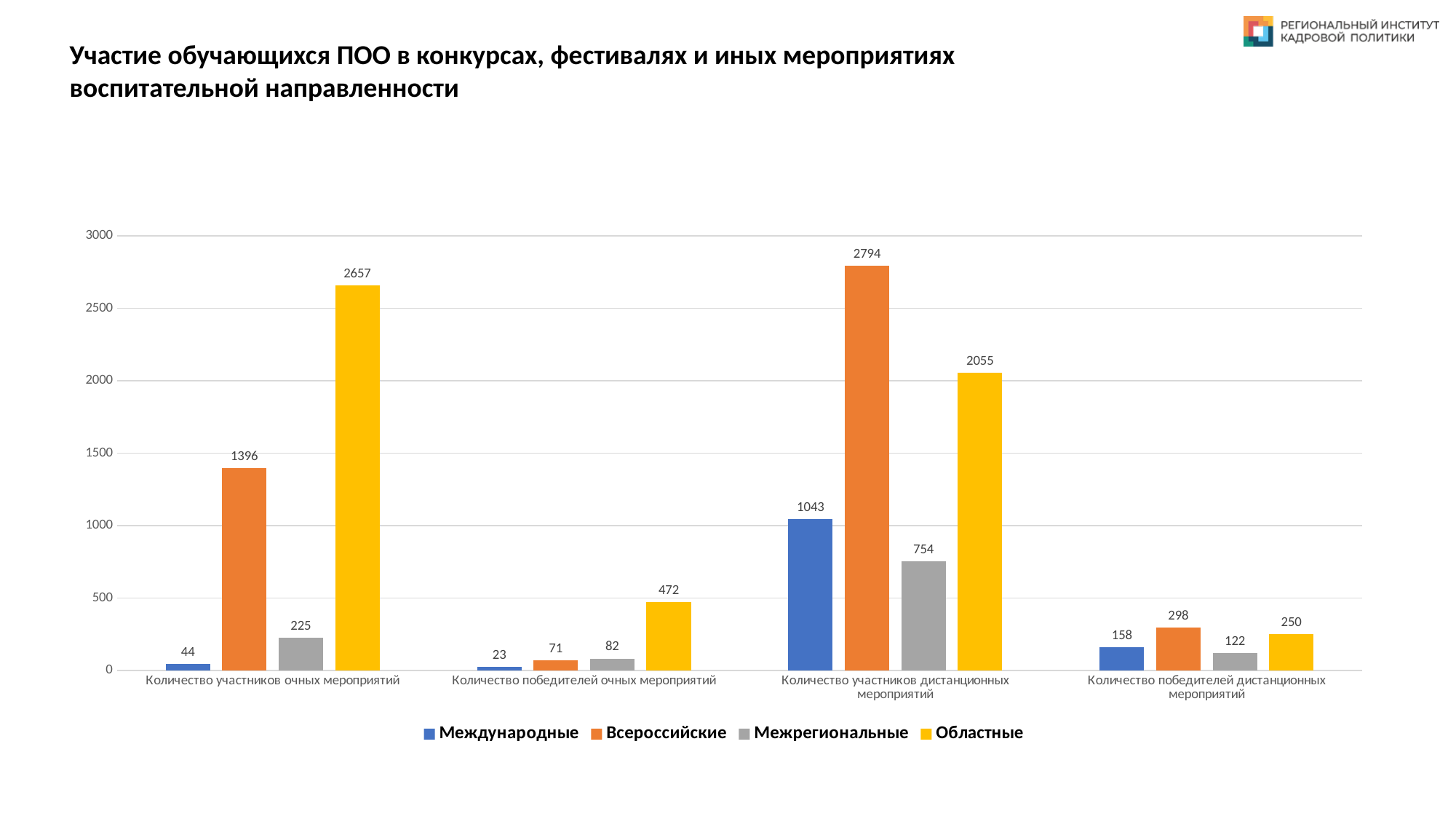
Which series has the lowest value in the category Количество победителей очных мероприятий? Международные What is the total of the four series in the category Количество победителей очных мероприятий? 648 Which colour represents the Областные series in the legend? Yellow What kind of chart is shown on the slide? Bar chart How many categories are shown on the x axis? 4 How many series does the legend list? 4 What is the difference between the Областные and Всероссийские values in the category Количество участников очных мероприятий? 1261 What is the value for Областные in the category Количество участников дистанционных мероприятий? 2055 Which series has the highest value in the category Количество участников дистанционных мероприятий? Всероссийские Which is larger: the Международные value for Количество участников дистанционных мероприятий or the Межрегиональные value for the same category? Международные What is the value for Межрегиональные in the category Количество победителей дистанционных мероприятий? 122 What is the value for Всероссийские in the category Количество участников очных мероприятий? 1396